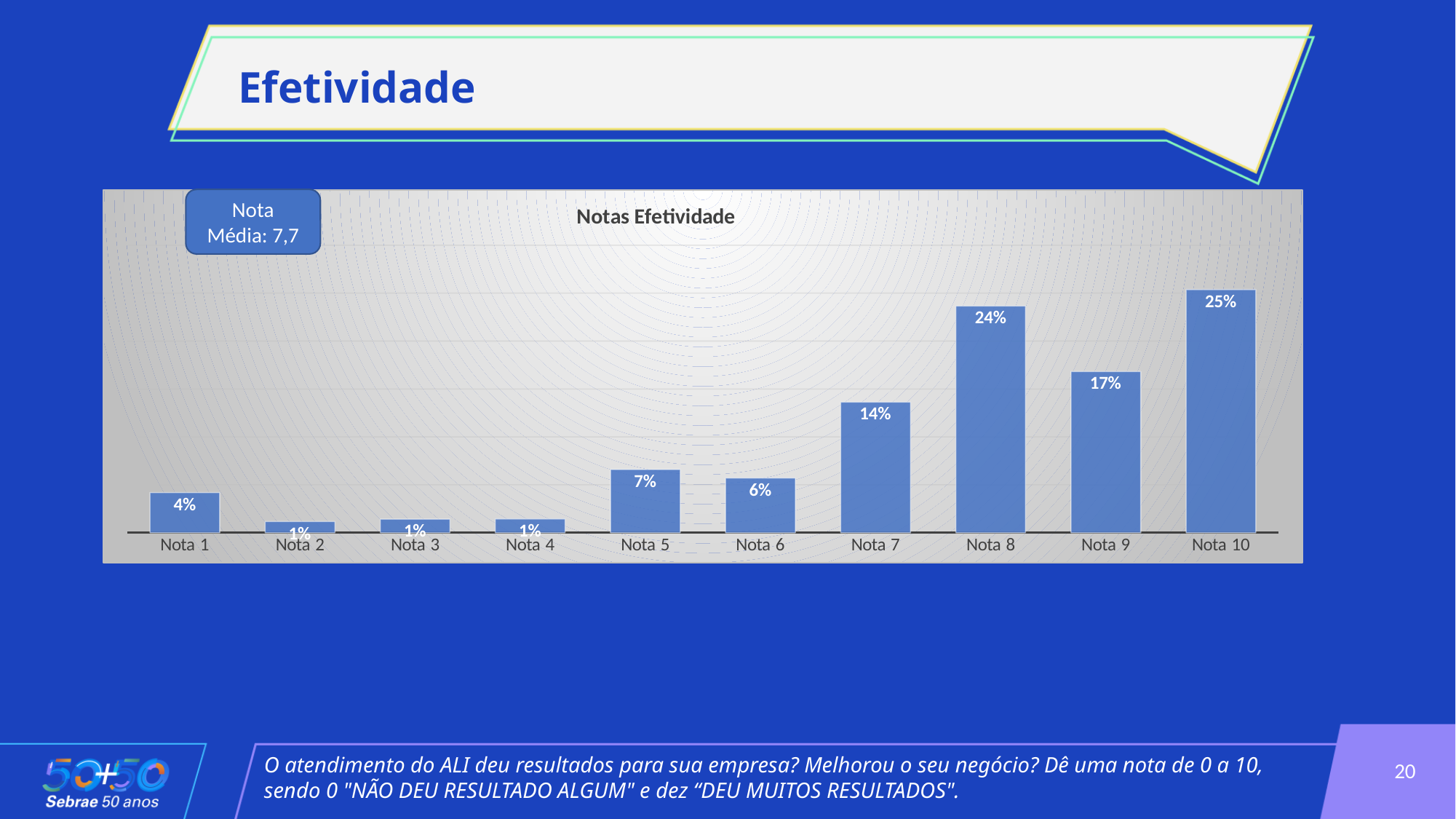
What kind of chart is this? Bar chart How many categories are shown on the x axis? 10 What is the value for Nota 7? 14% What is the value for Nota 10? 25% What is the difference between the values for Nota 10 and Nota 1? 21% What is the title of the chart? Notas Efetividade What is the value for Nota 1? 4% Which is larger, the value for Nota 5 or the value for Nota 6? Nota 5 What is the Nota Média shown on the chart? 7,7 What is the value for Nota 9? 17% What is the difference between the values for Nota 8 and Nota 9? 7% Which category has the highest value? Nota 10